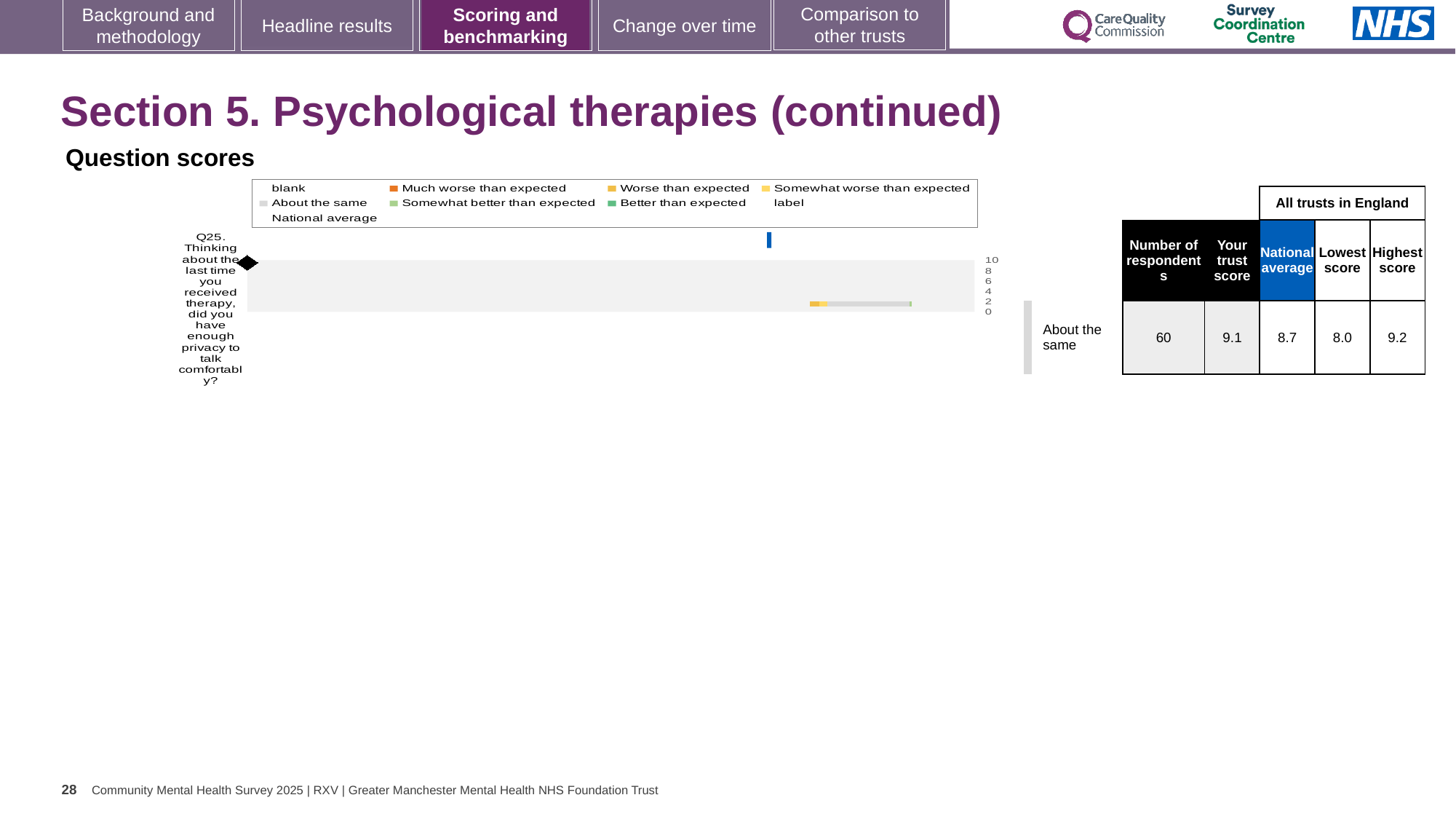
What is the difference between the highest and lowest scores for Q25 across all trusts in England? 1.2 Is the trust score for Q25 higher or lower than the national average? higher How many questions are plotted in the Question scores chart? 1 What is the number of respondents for Q25? 60 What is the national average score for Q25? 8.7 What is the difference between the trust score and the national average for Q25? 0.4 What is the lowest score among all trusts in England for Q25? 8.0 What kind of chart is shown under 'Question scores'? bar chart What is 'Your trust score' for Q25? 9.1 What is the highest score among all trusts in England for Q25? 9.2 What is the highest value shown on the chart's axis? 10 Which question is plotted in the Question scores chart? Q25